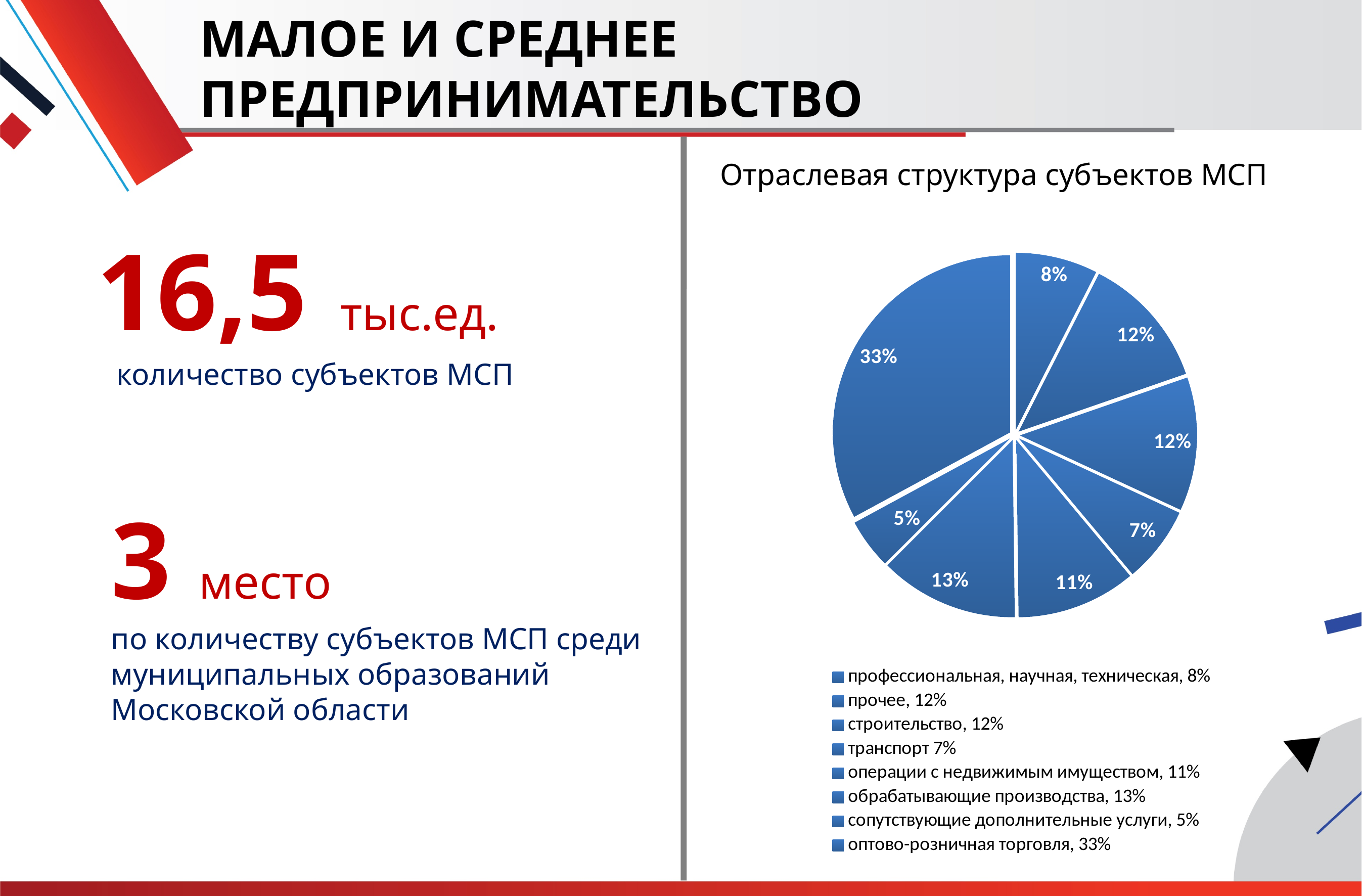
What is the title of the chart? Отраслевая структура субъектов МСП What kind of chart is shown on the slide? pie chart What is the value for обрабатывающие производства? 13% Which category has the largest share of the pie? оптово-розничная торговля How many slices does the pie chart have? 8 What share of the pie is оптово-розничная торговля? 33% What is the difference between the shares of оптово-розничная торговля and обрабатывающие производства? 20% What is the value for транспорт? 7% Which is larger: the share of строительство or the share of транспорт? строительство Which category has the smallest share of the pie? сопутствующие дополнительные услуги What is the value for операции с недвижимым имуществом? 11% What is the value for профессиональная, научная, техническая? 8%